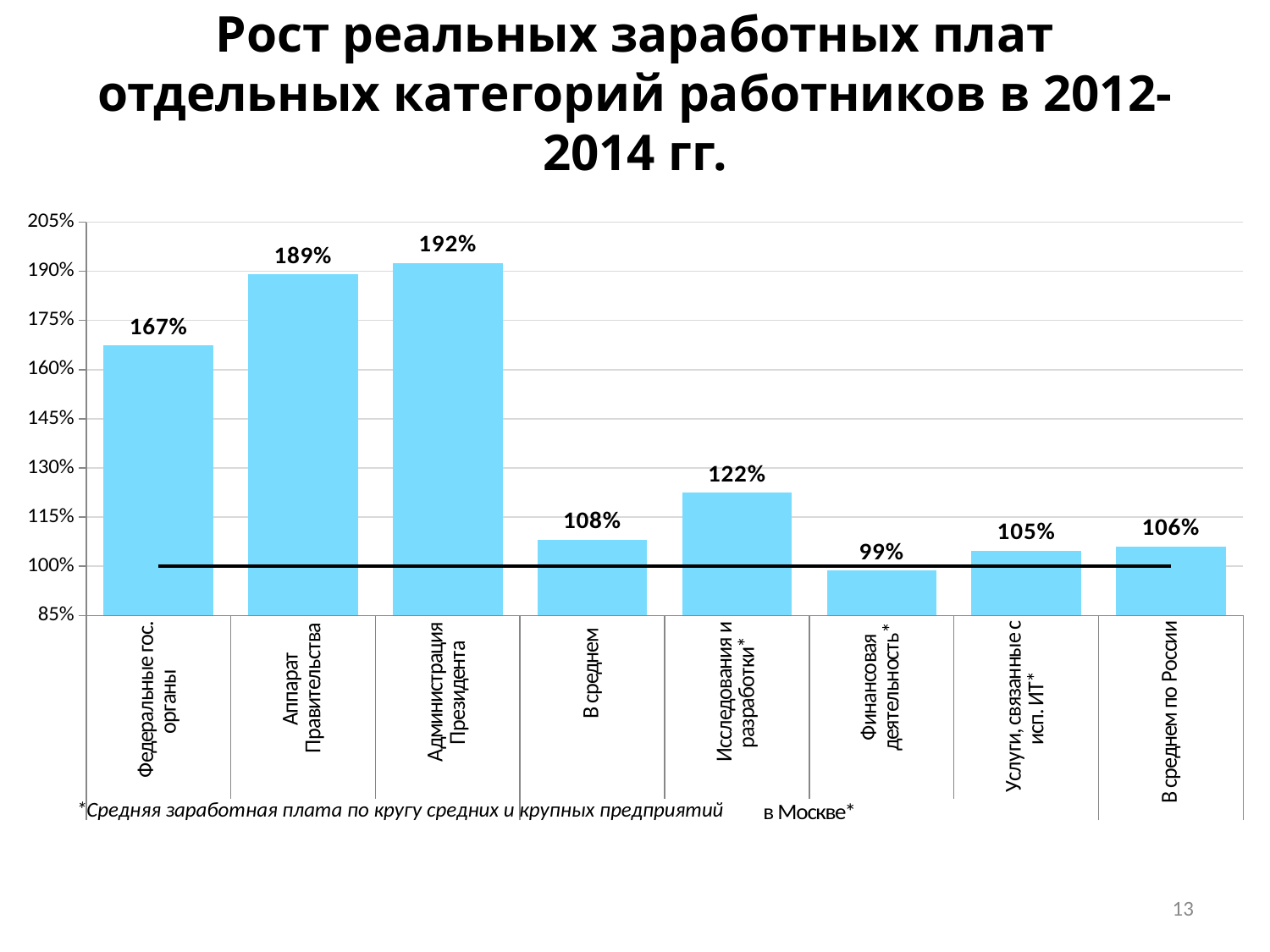
What is the difference between Аппарат Правительства and Федеральные гос. органы? 22% What kind of chart is shown on the slide? bar chart What is the value for Финансовая деятельность*? 99% How many categories are shown in the chart? 8 Which category has the highest value? Администрация Президента Is the value for В среднем greater or less than 100%? greater What is the difference between Администрация Президента and В среднем по России? 86% What is the value for В среднем по России? 106% Which category has the lowest value? Финансовая деятельность* Which is larger, Исследования и разработки* or Услуги, связанные с исп. ИТ*? Исследования и разработки* What is the value for Федеральные гос. органы? 167% What is the value for Администрация Президента? 192%